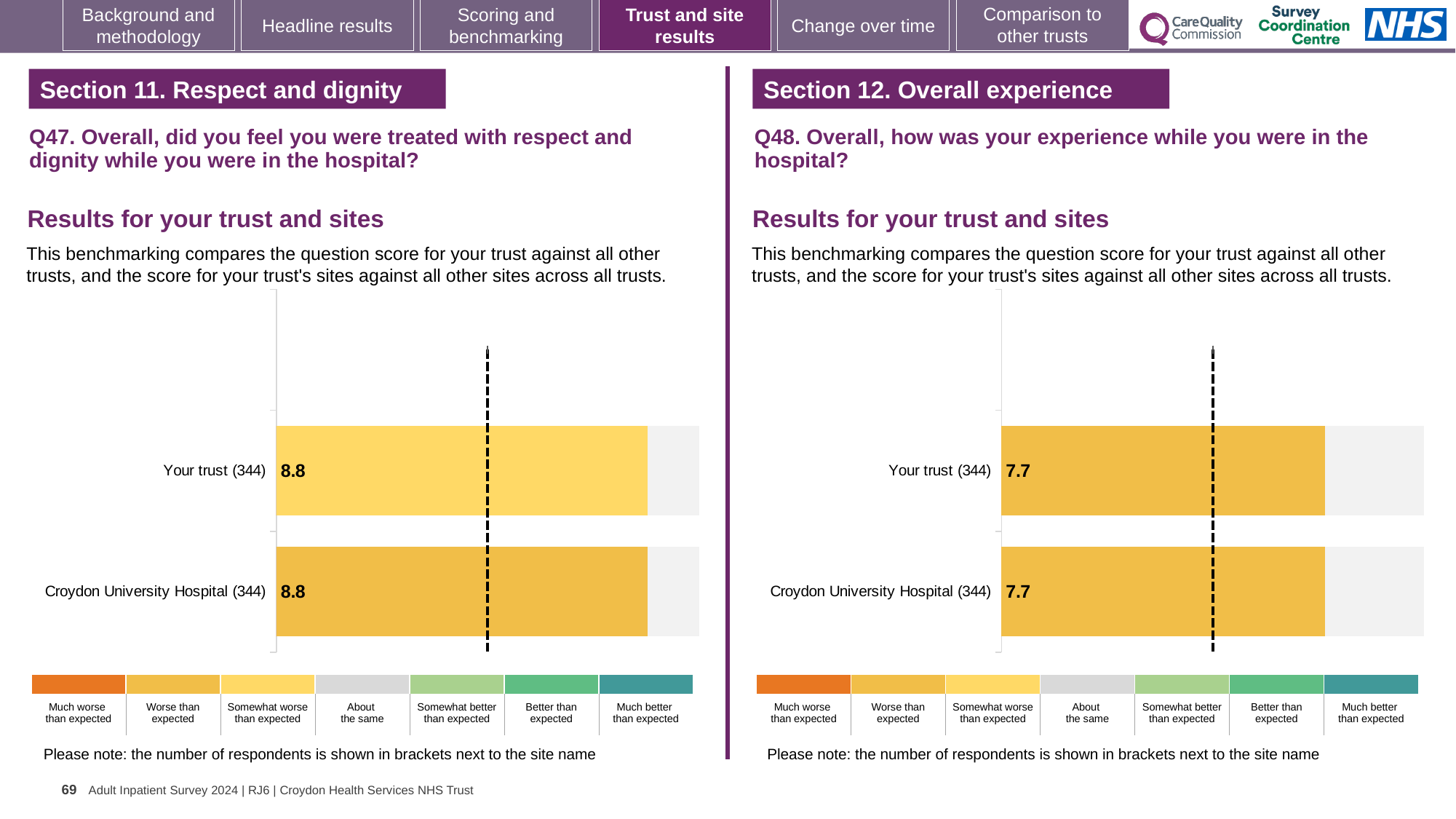
On the right chart (Q48, overall experience), what is the score for Your trust? 7.7 How many bars are plotted on the left chart (Q47)? 2 On the right chart (Q48), what is the difference between the score for Your trust and the score for Croydon University Hospital? 0 How many respondents are shown in brackets next to Croydon University Hospital on the right chart (Q48)? 344 What kind of chart is used on the left (Q47) to show the results for your trust and sites? Bar chart On the left chart (Q47, respect and dignity), what is the score for Croydon University Hospital? 8.8 On the right chart (Q48, overall experience), what is the score for Croydon University Hospital? 7.7 On the left chart (Q47, respect and dignity), what is the score for Your trust? 8.8 How many bars are plotted on the right chart (Q48)? 2 Is the score for Your trust on the left chart (Q47) larger or smaller than the score for Your trust on the right chart (Q48)? Larger How many categories does the colour key below the left chart (Q47) list? 7 On the left chart (Q47), what is the difference between the score for Your trust and the score for Croydon University Hospital? 0